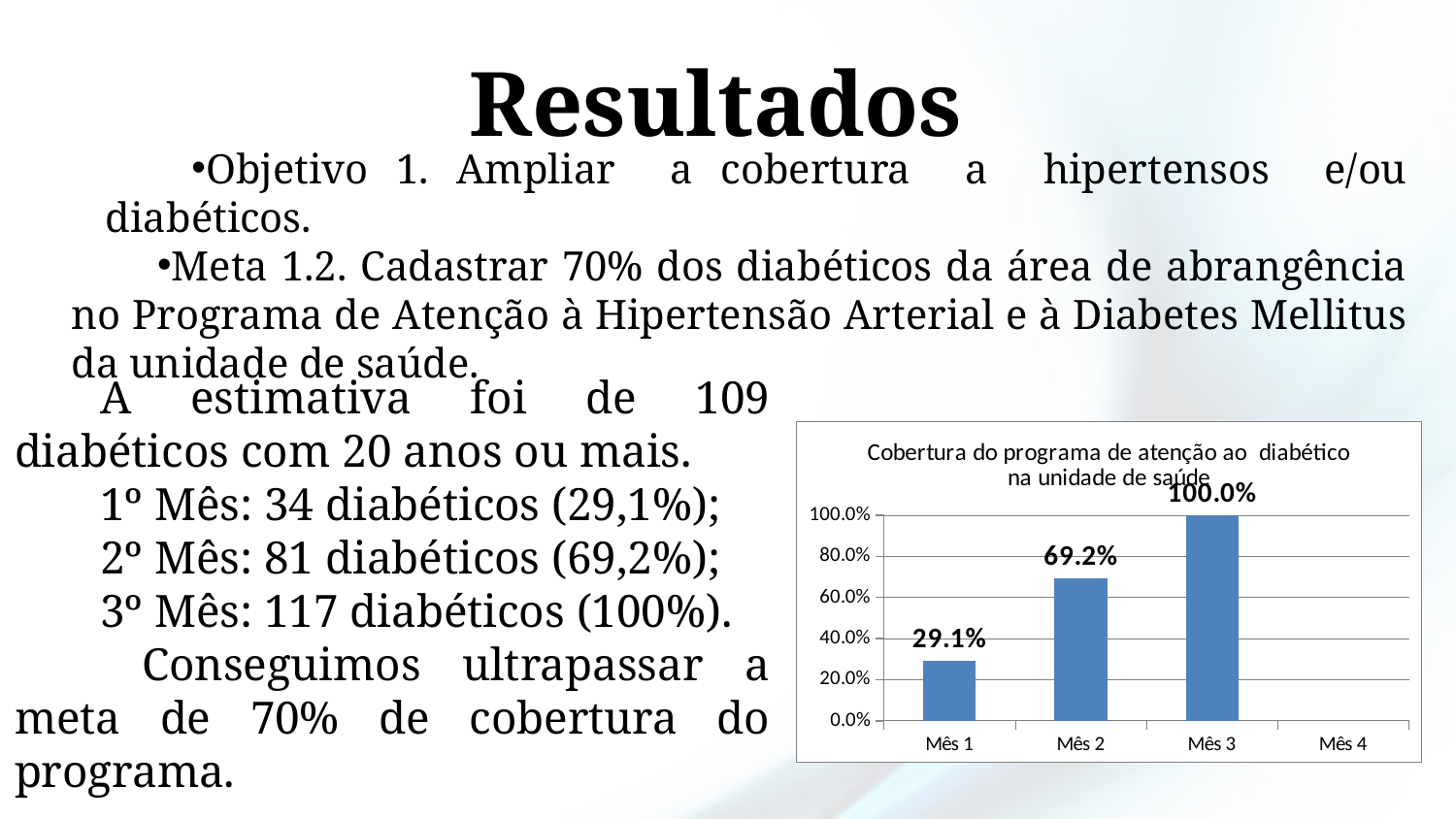
What is the value for Mês 3? 100.0% What is the value for Mês 2? 69.2% How many month categories are labelled on the x axis? 4 What is the difference between the values for Mês 2 and Mês 1? 40.1% What is the value for Mês 1? 29.1% Do the values rise or fall from Mês 1 to Mês 3? rise What is the difference between the values for Mês 3 and Mês 2? 30.8% What kind of chart is shown on the slide? bar chart Which is larger, the value for Mês 1 or the value for Mês 2? Mês 2 Which month with a plotted bar has the lowest value? Mês 1 Is the value for Mês 2 greater or less than 60.0%? greater Which month has the highest value? Mês 3